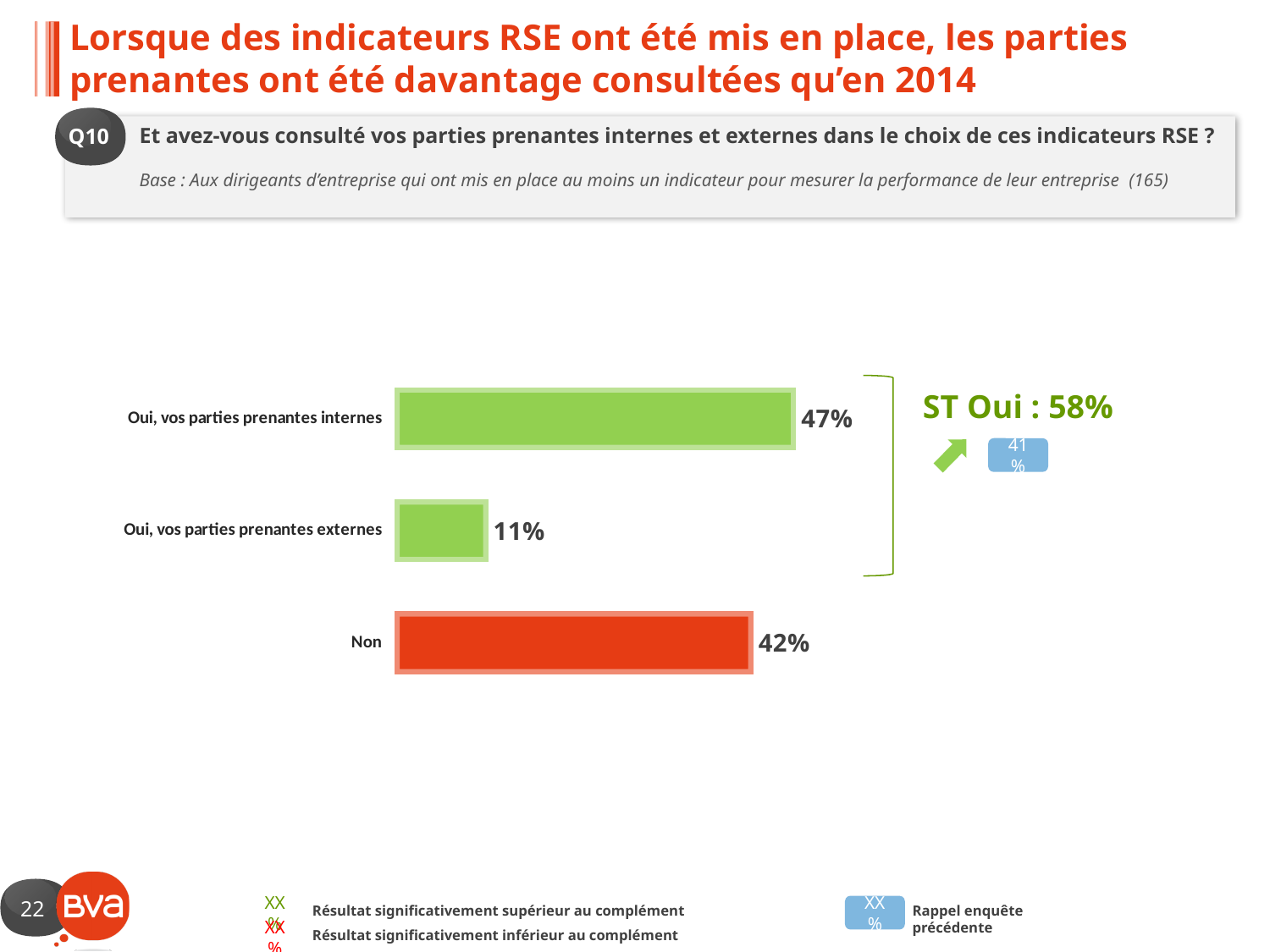
What is the value for "Oui, vos parties prenantes internes"? 47% What kind of chart is shown on the slide? Bar chart Which category has the lowest value? Oui, vos parties prenantes externes How many categories are shown in the chart? 3 What colour is the bar for "Non"? Red What is the value for "Non"? 42% Which category has the highest value? Oui, vos parties prenantes internes Which is larger, the value for "Oui, vos parties prenantes internes" or the value for "Non"? Oui, vos parties prenantes internes What is the difference between the values for "Oui, vos parties prenantes internes" and "Non"? 5% What is the "ST Oui" total shown next to the chart? 58% What is the difference between the values for "Non" and "Oui, vos parties prenantes externes"? 31% What is the value for "Oui, vos parties prenantes externes"? 11%